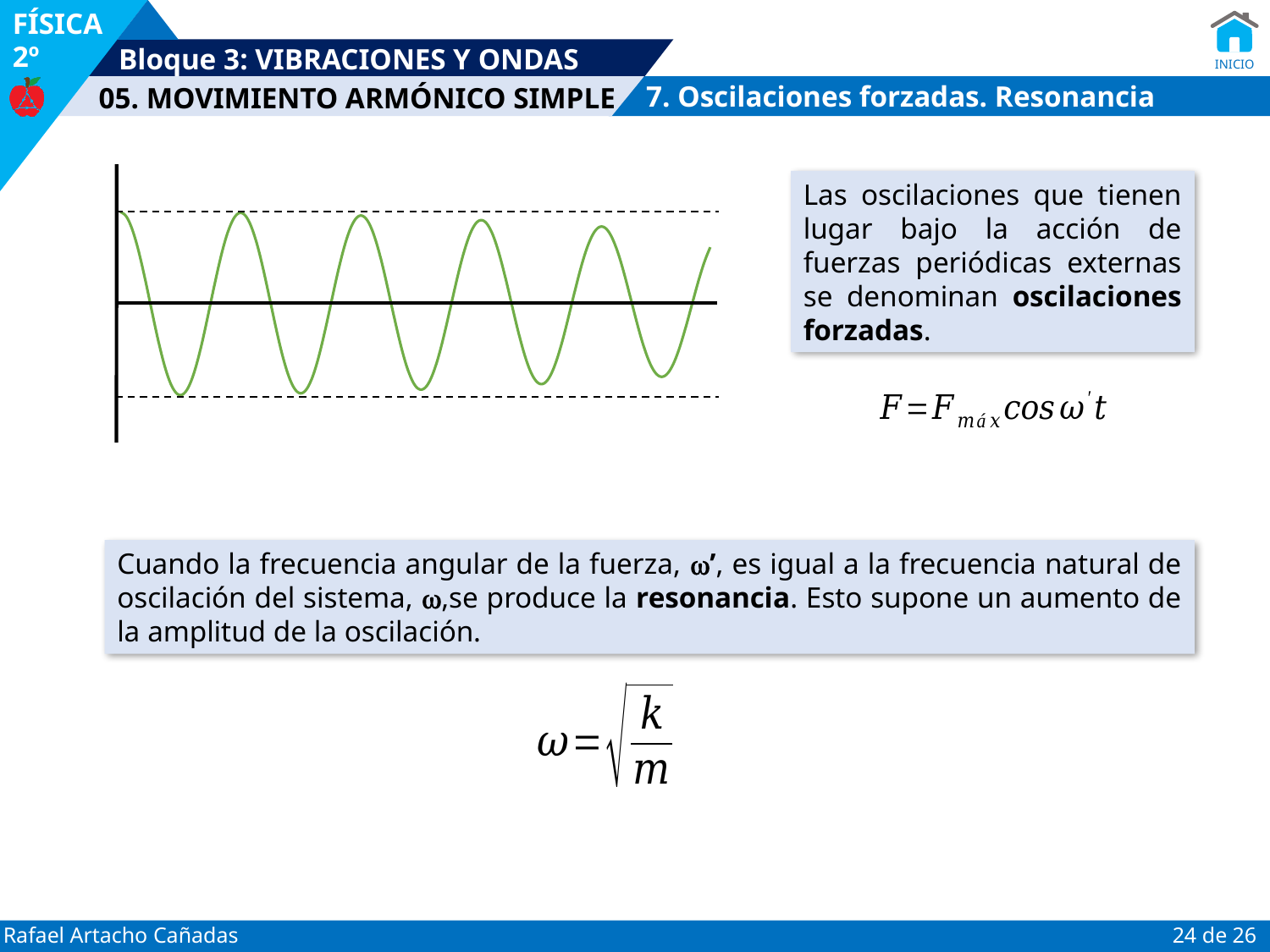
Does the amplitude of the green curve increase, decrease or stay constant along the x axis? decrease How many horizontal dashed lines are drawn in the chart? 2 What colour is the oscillating line in the chart? green What kind of chart is shown on the left of the slide? line chart How many data series are plotted in the chart on the left? 1